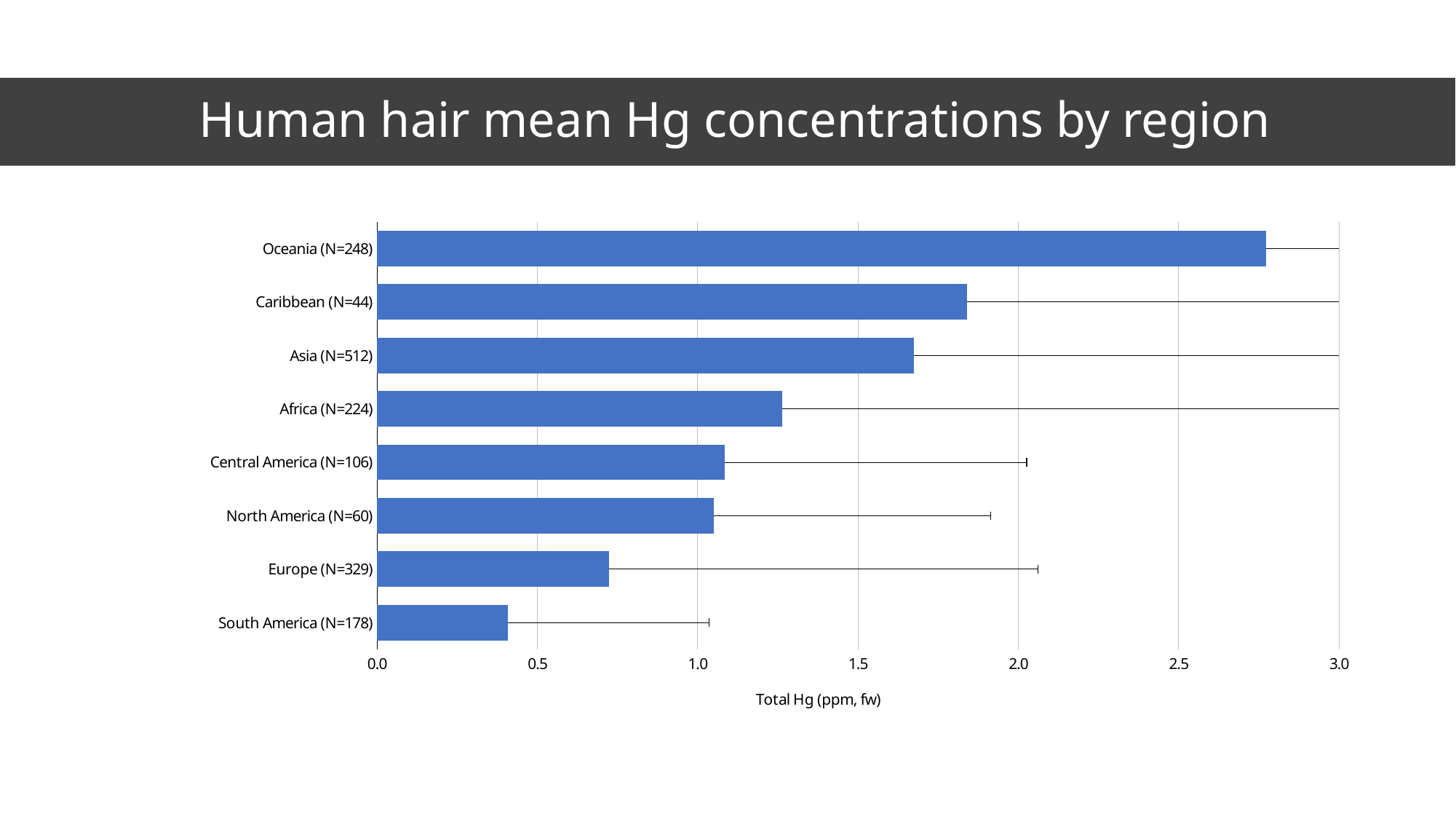
Which region has the highest mean Hg concentration? Oceania (N=248) How many regions are plotted in the chart? 8 Is the value for Caribbean (N=44) greater or less than 2.0? less What is the label of the horizontal axis? Total Hg (ppm, fw) Which has a higher mean Hg concentration, Africa (N=224) or Europe (N=329)? Africa (N=224) Is the value for South America (N=178) greater or less than 0.5? less Is the value for Europe (N=329) greater or less than 1.0? less What kind of chart is shown on the slide? bar chart Which region has the lowest mean Hg concentration? South America (N=178) Which has a higher mean Hg concentration, Caribbean (N=44) or Asia (N=512)? Caribbean (N=44)